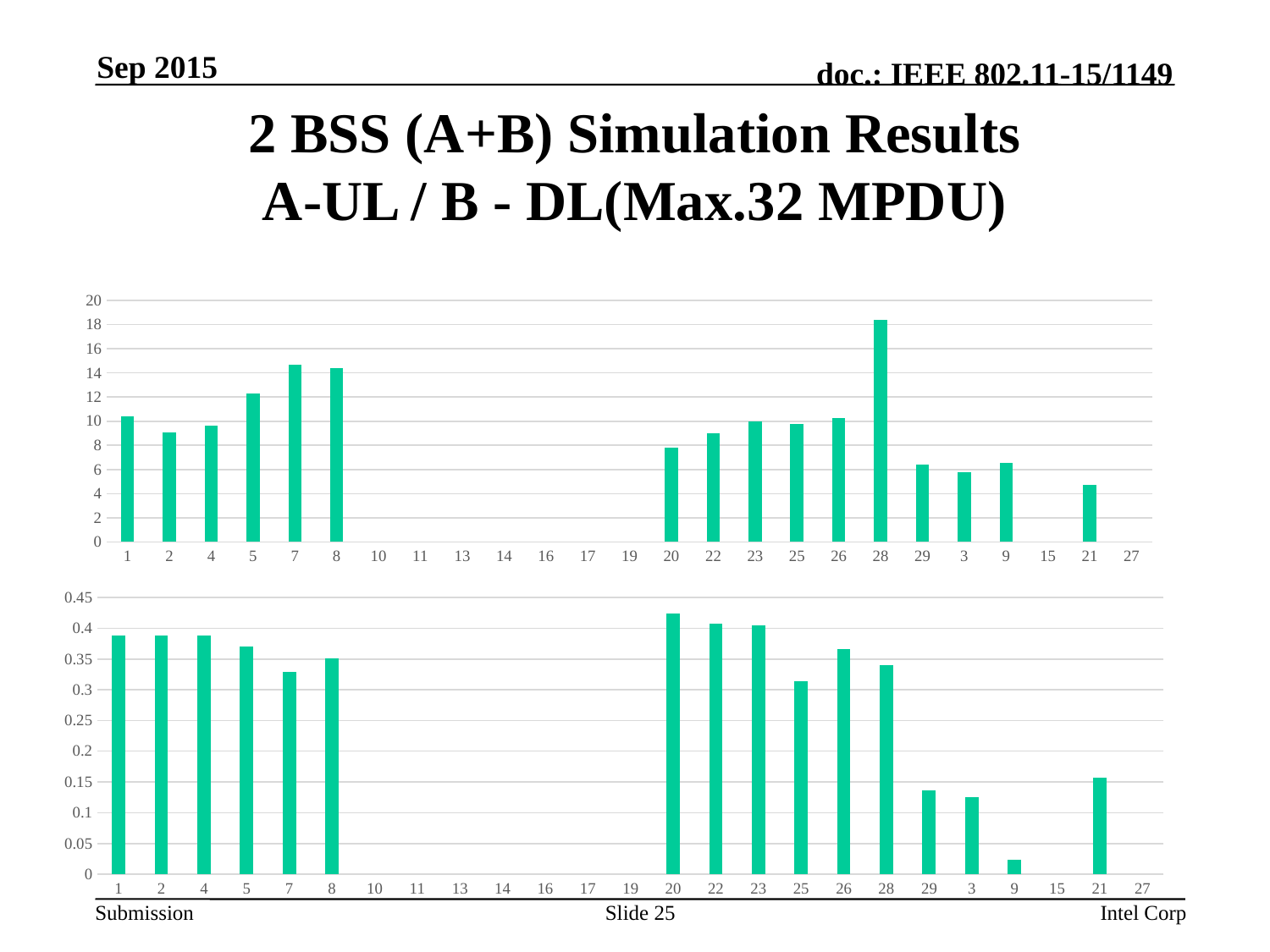
In the top chart, which is larger, the value for category 28 or the value for category 26? 28 In the bottom chart, which category has the tallest bar? 20 In the bottom chart, is the value for category 20 greater or less than 0.4? greater How many categories are shown on the x axis of the top chart? 25 In the bottom chart, is the value for category 9 greater or less than 0.05? less In the top chart, is the value for category 21 greater or less than 6? less What kind of chart is the top chart on the slide? bar chart In the top chart, which category has the tallest bar? 28 In the bottom chart, which is larger, the value for category 1 or the value for category 7? 1